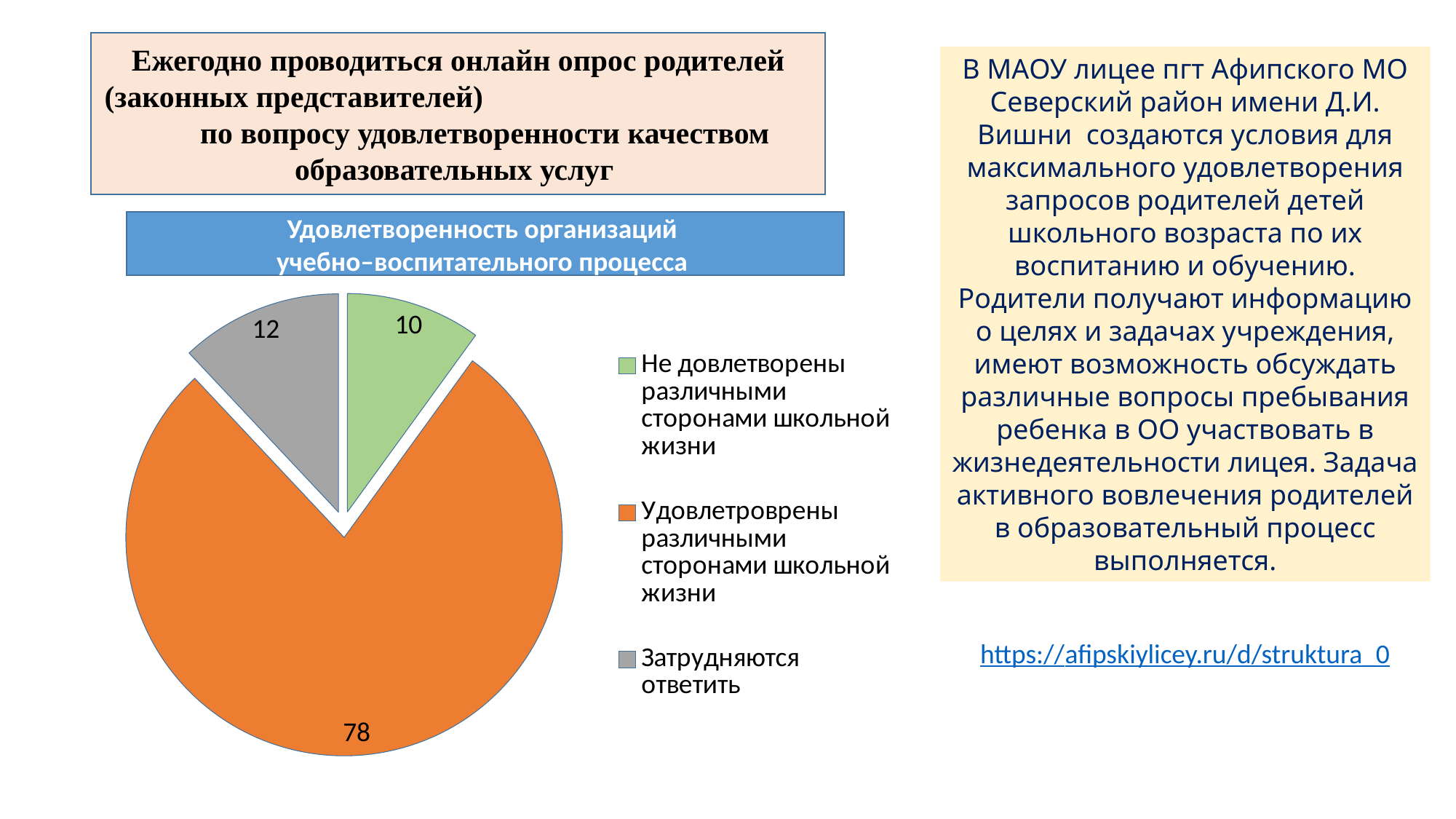
What is the difference between the values for "Удовлетроврены различными сторонами школьной жизни" and "Затрудняются ответить"? 66 What colour is the slice for "Затрудняются ответить"? Grey Which is larger: the value for "Затрудняются ответить" or the value for "Не довлетворены различными сторонами школьной жизни"? Затрудняются ответить What is the value for "Затрудняются ответить"? 12 Which category has the smallest slice of the pie? Не довлетворены различными сторонами школьной жизни What kind of chart is shown on the slide? Pie chart Which category has the largest slice of the pie? Удовлетроврены различными сторонами школьной жизни What is the value for "Не довлетворены различными сторонами школьной жизни"? 10 What is the difference between the values for "Затрудняются ответить" and "Не довлетворены различными сторонами школьной жизни"? 2 What is the value for "Удовлетроврены различными сторонами школьной жизни"? 78 What share of the pie does "Удовлетроврены различными сторонами школьной жизни" represent? 78% How many slices does the pie chart have? 3